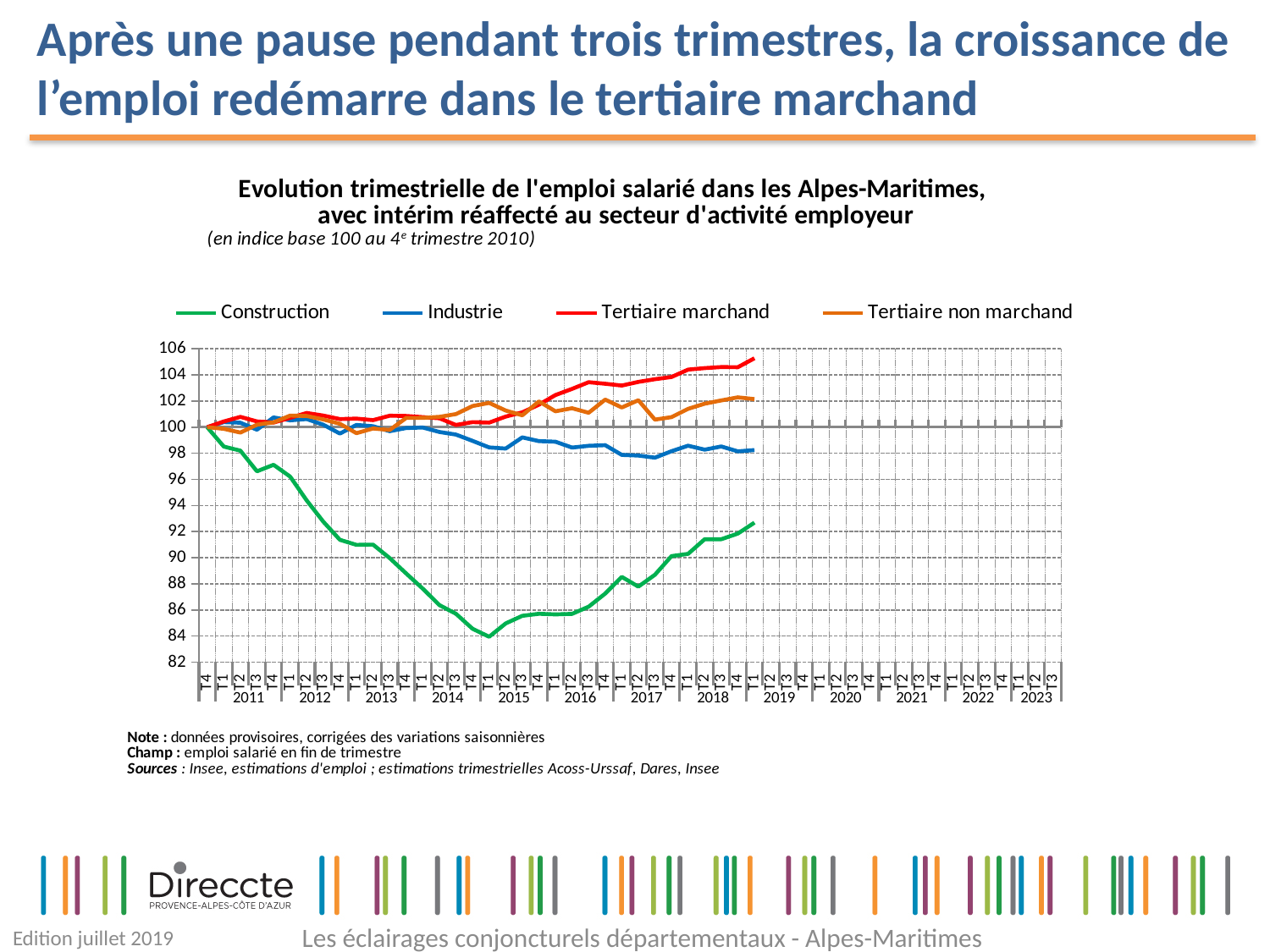
Is the value for Construction at T1 2015 greater or less than 86? less Does the Construction series rise or fall between 2011 and T1 2015? Fall How many series does the legend list? 4 Which series has the lowest value at T1 2019? Construction What is the index value of all series at T4 2010, the base quarter? 100 Which series has the highest value at T1 2019? Tertiaire marchand Is the value for Construction at T1 2019 greater or less than 90? greater Which colour is used for the Construction series? Green Is the value for Tertiaire marchand at T1 2019 greater or less than 104? greater What kind of chart is shown on the slide? Line chart What is the title of the chart? Evolution trimestrielle de l'emploi salarié dans les Alpes-Maritimes, avec intérim réaffecté au secteur d'activité employeur